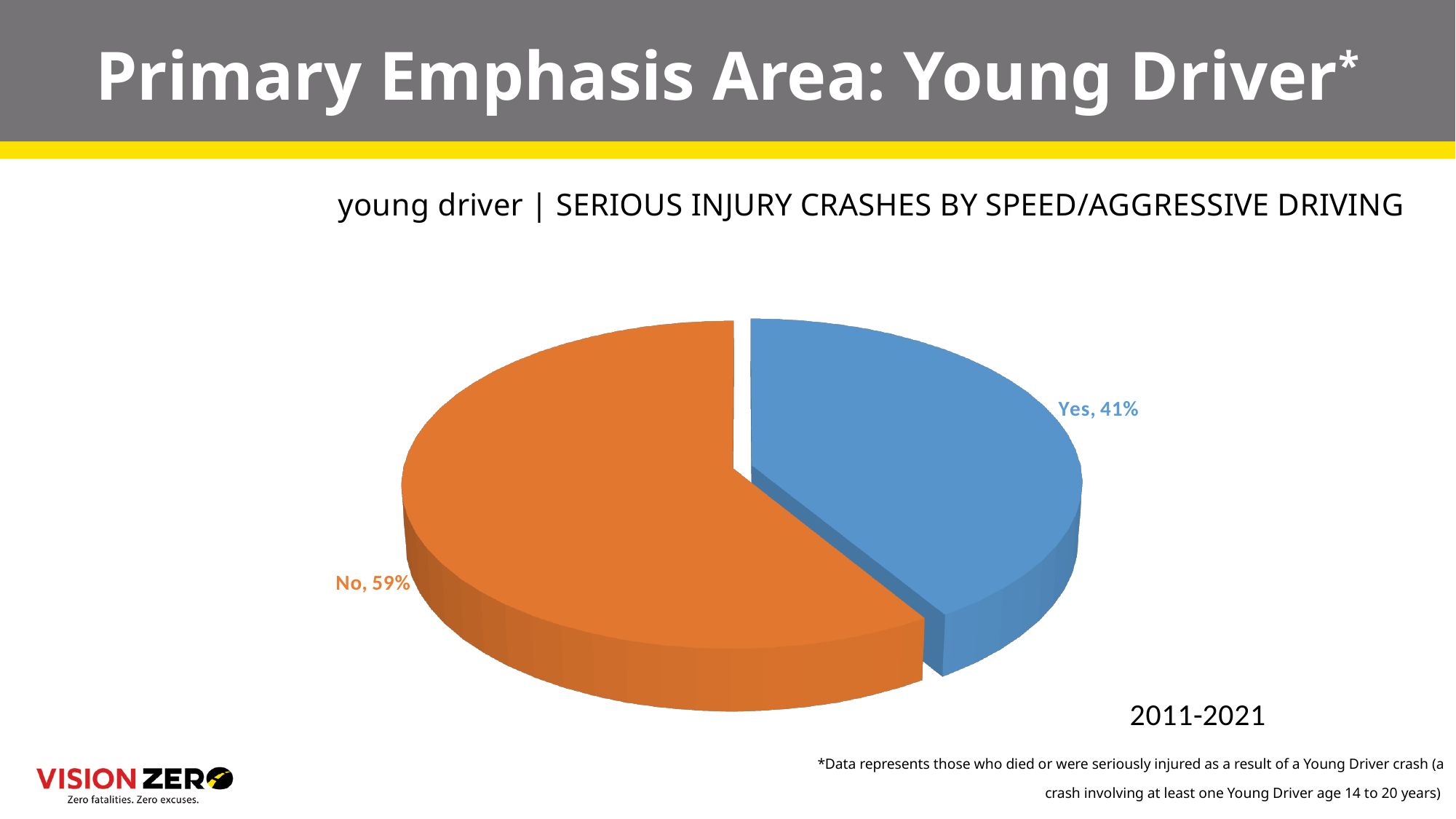
Which category has the largest share of the pie? No Which category has the smallest share of the pie? Yes What is the title of the chart? young driver | SERIOUS INJURY CRASHES BY SPEED/AGGRESSIVE DRIVING Which slice of the pie is larger, Yes or No? No What kind of chart is shown on the slide? Pie chart How many slices does the pie chart have? 2 What time period does the chart cover? 2011-2021 What is the difference in percentage points between the No and Yes slices? 18 What share of young driver serious injury crashes did not involve speed/aggressive driving (No)? 59% What colour is the Yes slice of the pie? Blue What share of young driver serious injury crashes involved speed/aggressive driving (Yes)? 41%